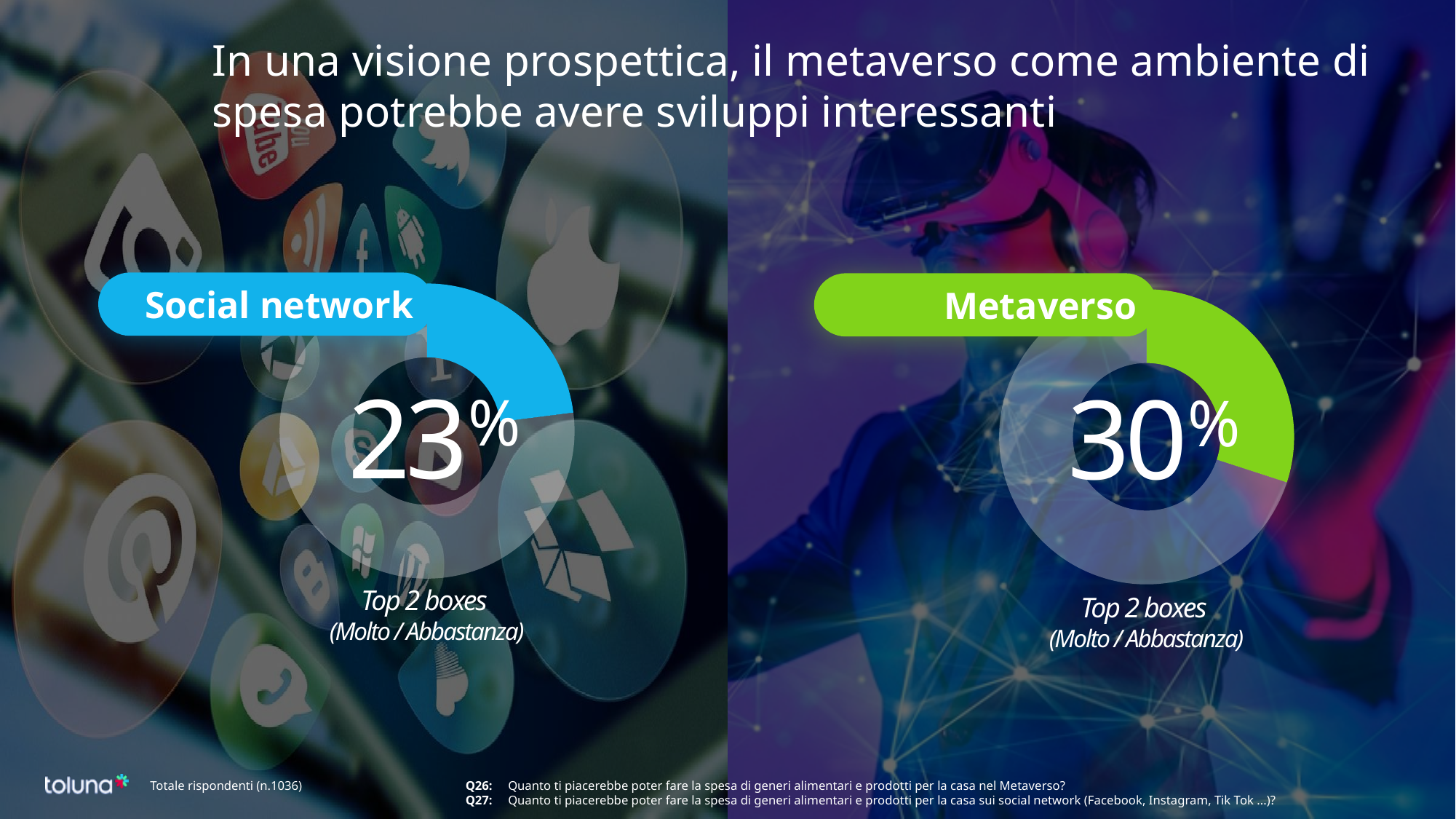
In the Metaverso chart, what share of the full ring does the filled portion represent? 30% What is the total number of respondents stated on the slide? 1036 In the Social network chart, what colour is the filled portion of the ring? Blue How many charts are shown on the slide? 2 Which of the two charts shows the higher value, Social network or Metaverso? Metaverso In the Metaverso chart, what colour is the filled portion of the ring? Green In the Metaverso chart, what percentage is shown? 30% In the Social network chart, what percentage is shown? 23% What is the difference in percentage points between the Metaverso value and the Social network value? 7 What kind of chart is used to show the Social network value? Donut chart Which of the two charts shows the lower value, Social network or Metaverso? Social network